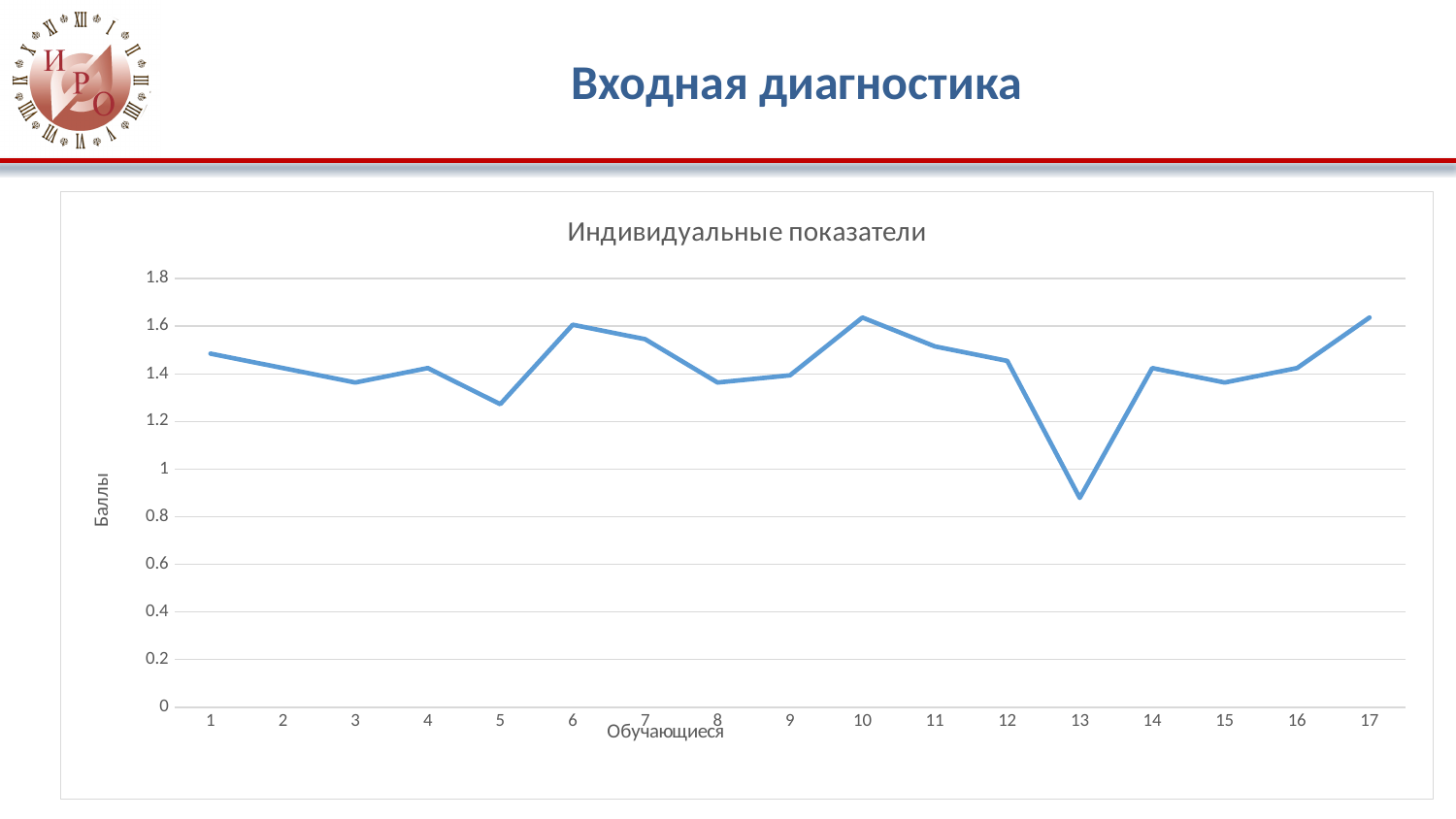
What is the label of the vertical axis? Баллы How many points (обучающиеся) are plotted along the x axis? 17 What kind of chart is shown on the slide? line chart Is the value for обучающийся 10 greater or less than 1.4? greater Which has the larger value, обучающийся 5 or обучающийся 6? 6 Is the value for обучающийся 13 greater or less than 1? less What is the title of the chart? Индивидуальные показатели Is the value for обучающийся 6 greater or less than 1.4? greater Which обучающийся has the lowest value? 13 Does the line rise or fall from обучающийся 12 to обучающийся 13? fall Which has the larger value, обучающийся 13 or обучающийся 14? 14